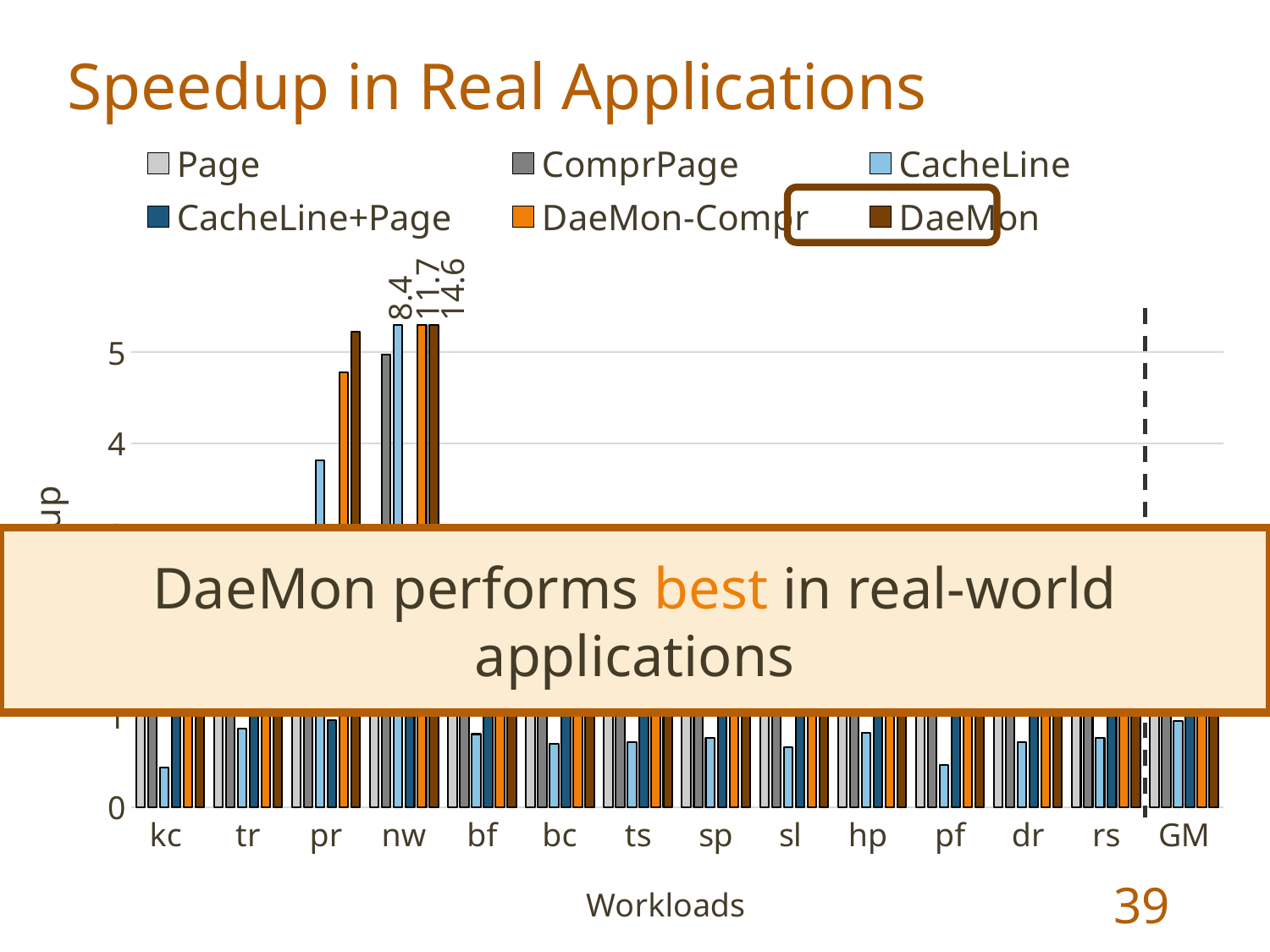
Is the CacheLine value for the kc workload greater or less than 1? less What is the title of the x axis? Workloads For the nw workload, what is the difference between the DaeMon and CacheLine speedups? 6.2 Is the DaeMon-Compr value for the pr workload greater or less than 4? greater What is the DaeMon speedup for the nw workload? 14.6 What kind of chart is shown on the slide? bar chart How many series does the legend list? 6 How many workload categories are shown on the x axis? 14 What is the CacheLine speedup for the nw workload? 8.4 What is the DaeMon-Compr speedup for the nw workload? 11.7 For the nw workload, what is the difference between the DaeMon and DaeMon-Compr speedups? 2.9 Which series has the highest speedup for the nw workload? DaeMon